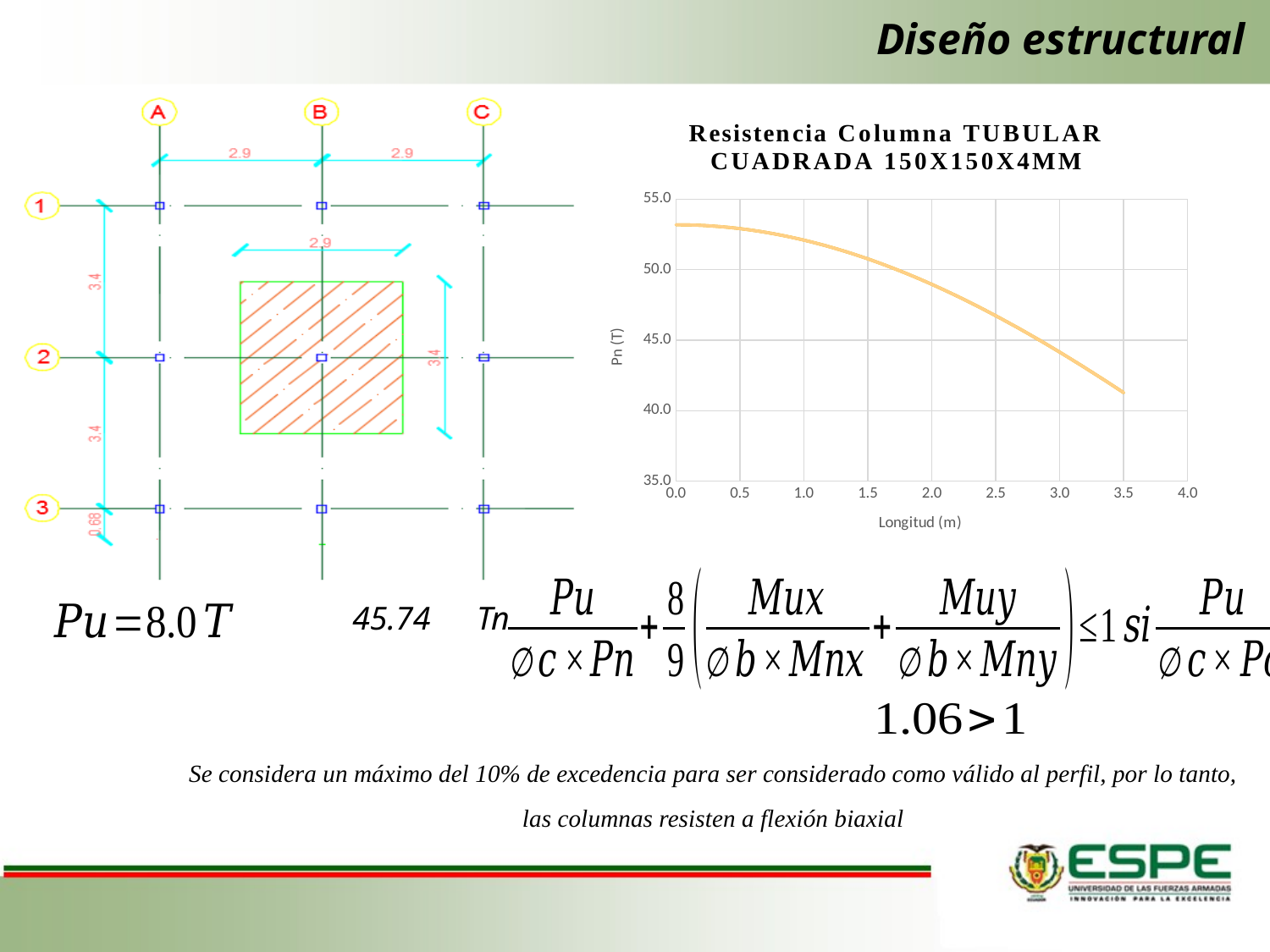
What kind of chart is shown on the slide? line chart What is the title of the chart? Resistencia Columna TUBULAR CUADRADA 150X150X4MM Is the value of Pn at Longitud 0.0 m greater or less than 50.0? greater What is the label of the x axis of the chart? Longitud (m) At which Longitud shown on the x axis is Pn highest? 0.0 m Is the value of Pn at Longitud 3.5 m greater or less than 40.0? greater Is the value of Pn at Longitud 3.5 m greater or less than 45.0? less Does Pn rise or fall as Longitud increases along the x axis? fall Which has the larger Pn value: Longitud 0.5 m or Longitud 3.0 m? 0.5 m At which Longitud does the curve reach its lowest Pn value? 3.5 m